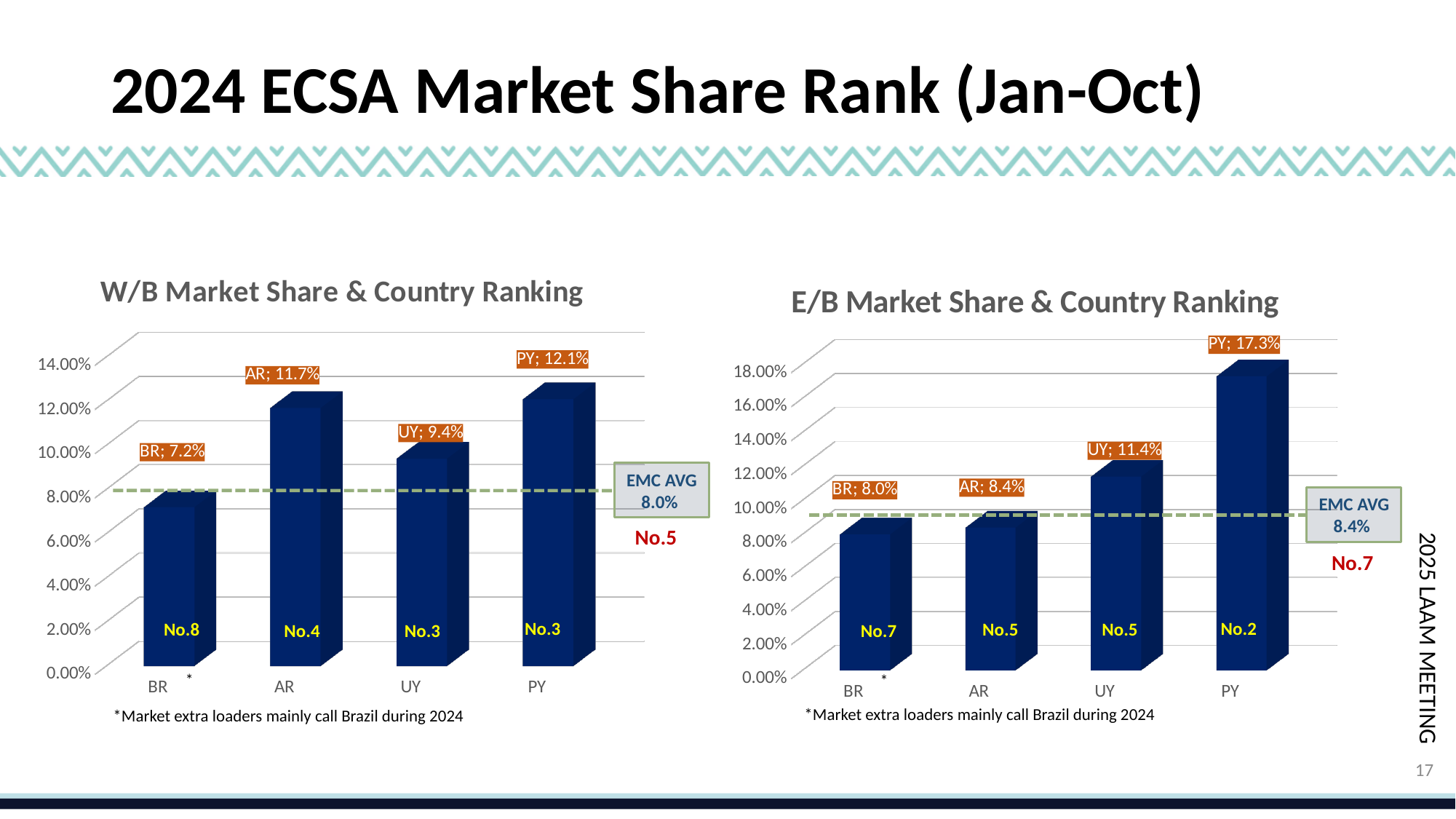
In the E/B Market Share & Country Ranking chart, which is larger, the market share for UY or for AR? UY What kind of chart is the E/B Market Share & Country Ranking chart? Bar chart In the E/B Market Share & Country Ranking chart, which country has the lowest market share? BR In the W/B Market Share & Country Ranking chart, what ranking is shown on the BR bar? No.8 In the E/B Market Share & Country Ranking chart, what is the EMC AVG value shown? 8.4% In the W/B Market Share & Country Ranking chart, which country has the highest market share? PY In the E/B Market Share & Country Ranking chart, what is the difference between the market shares of PY and UY? 5.9% In the W/B Market Share & Country Ranking chart, is the value for UY greater or less than 8.00%? greater In the E/B Market Share & Country Ranking chart, what is the market share for PY? 17.3% In the W/B Market Share & Country Ranking chart, what is the difference between the market shares of PY and BR? 4.9% In the W/B Market Share & Country Ranking chart, how many countries are plotted? 4 In the W/B Market Share & Country Ranking chart, what is the market share for AR? 11.7%